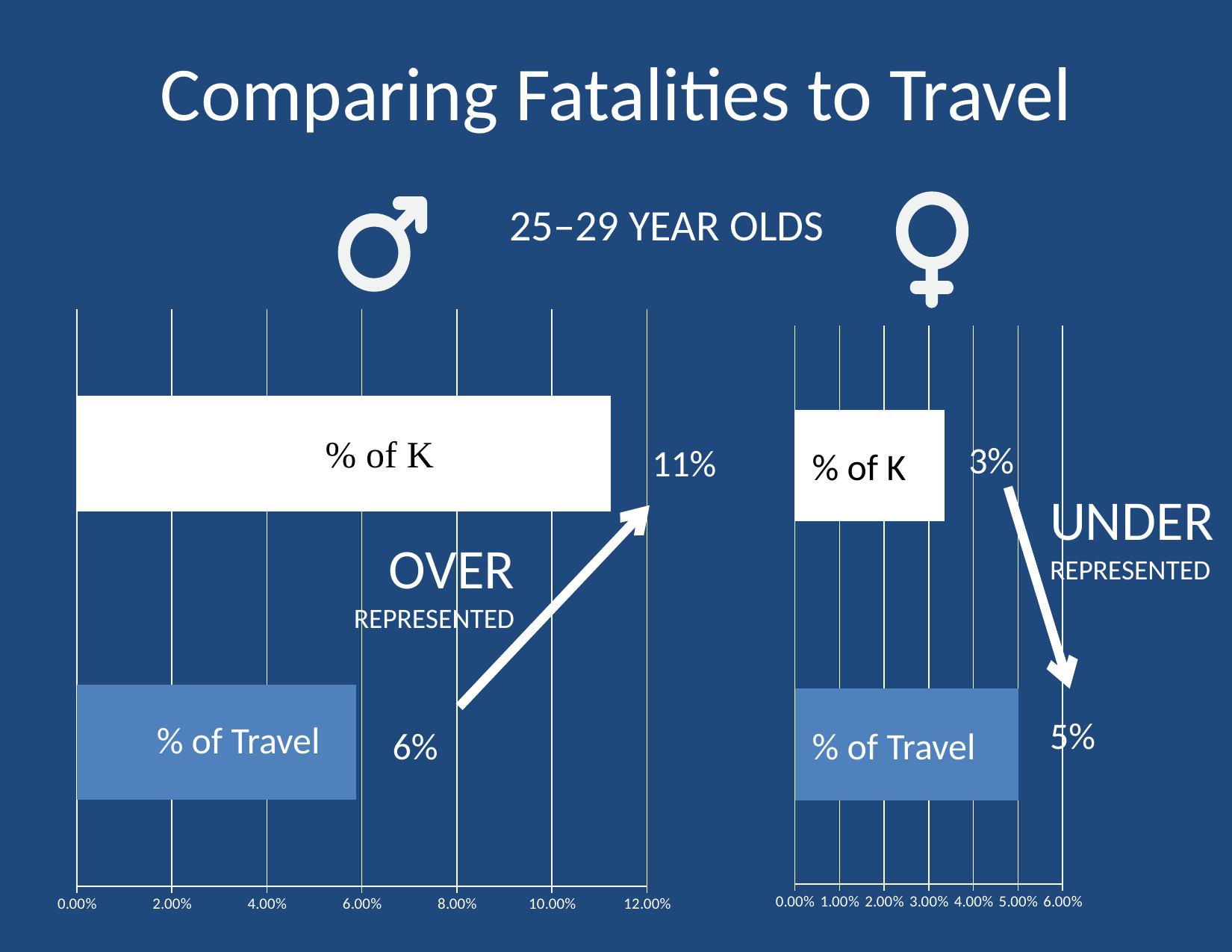
On the right chart (female), what is the value for % of K? 3% On the right chart (female), what is the value for % of Travel? 5% How many bars are plotted on the right chart (female)? 2 On the right chart (female), what is the difference between % of Travel and % of K? 2% On the left chart (male), is the value for % of K greater or less than 10.00%? greater On the left chart (male), what is the value for % of Travel? 6% What is the title of the slide? Comparing Fatalities to Travel On the left chart (male), what is the value for % of K? 11% On the right chart (female), which bar is longer, % of K or % of Travel? % of Travel What kind of chart is shown on the left side of the slide? Bar chart On the left chart (male), what is the difference between % of K and % of Travel? 5% On the left chart (male), which bar is longer, % of K or % of Travel? % of K